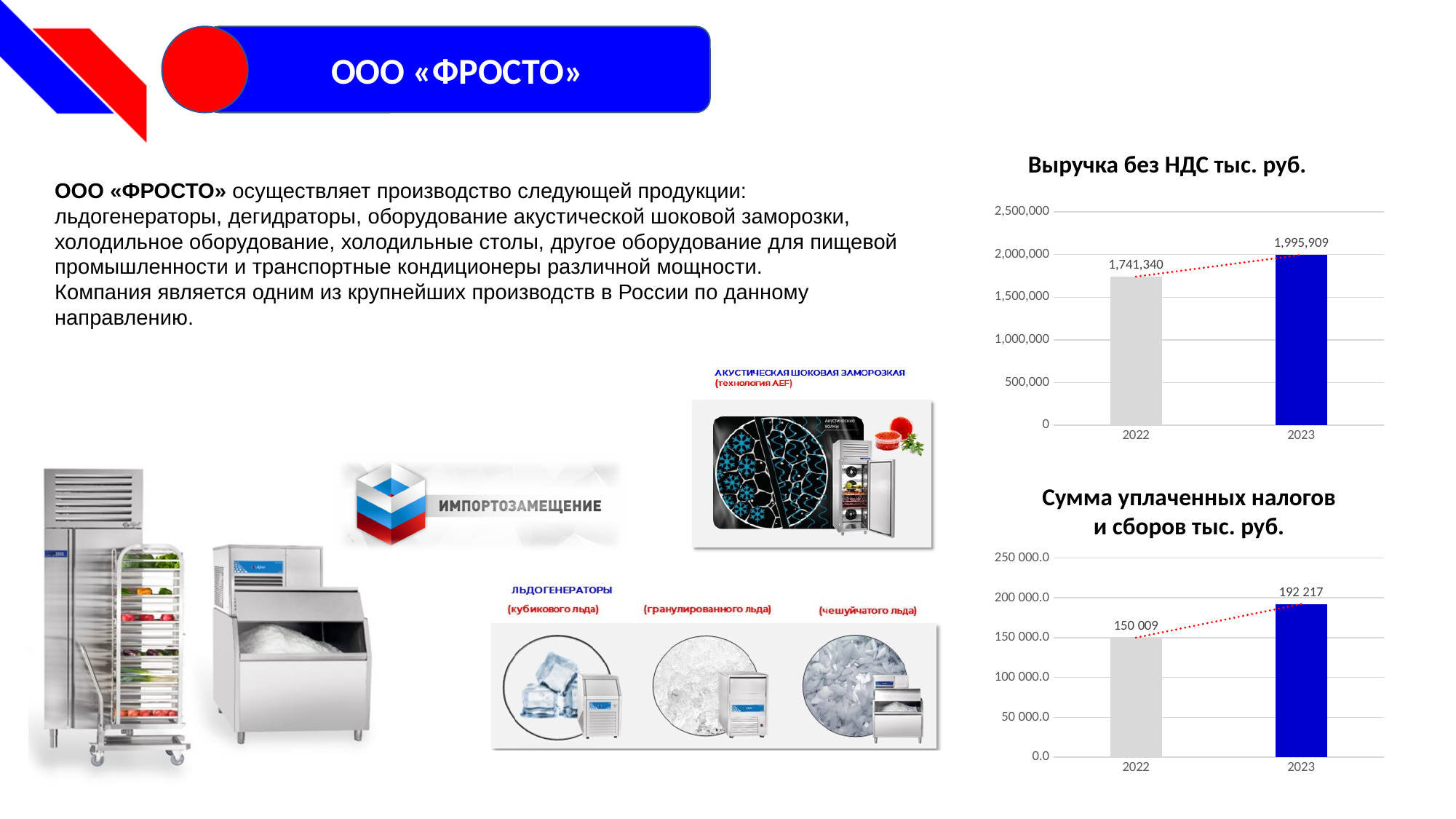
In the chart titled "Выручка без НДС тыс. руб.", do the values rise or fall from 2022 to 2023? rise In the chart titled "Выручка без НДС тыс. руб.", is the value for 2022 greater or less than 2,000,000? less In the chart titled "Выручка без НДС тыс. руб.", what is the difference between the 2023 and 2022 values? 254,569 In the chart titled "Сумма уплаченных налогов и сборов тыс. руб.", what is the value for 2022? 150 009 In the chart titled "Выручка без НДС тыс. руб.", which year has the higher value? 2023 How many categories are shown on the x axis of the chart titled "Сумма уплаченных налогов и сборов тыс. руб."? 2 What kind of chart is the chart titled "Выручка без НДС тыс. руб."? bar chart In the chart titled "Выручка без НДС тыс. руб.", what is the value for 2023? 1,995,909 In the chart titled "Сумма уплаченных налогов и сборов тыс. руб.", what is the value for 2023? 192 217 In the chart titled "Сумма уплаченных налогов и сборов тыс. руб.", which year has the lower value? 2022 In the chart titled "Выручка без НДС тыс. руб.", what is the value for 2022? 1,741,340 In the chart titled "Сумма уплаченных налогов и сборов тыс. руб.", what is the difference between the 2023 and 2022 values? 42 208